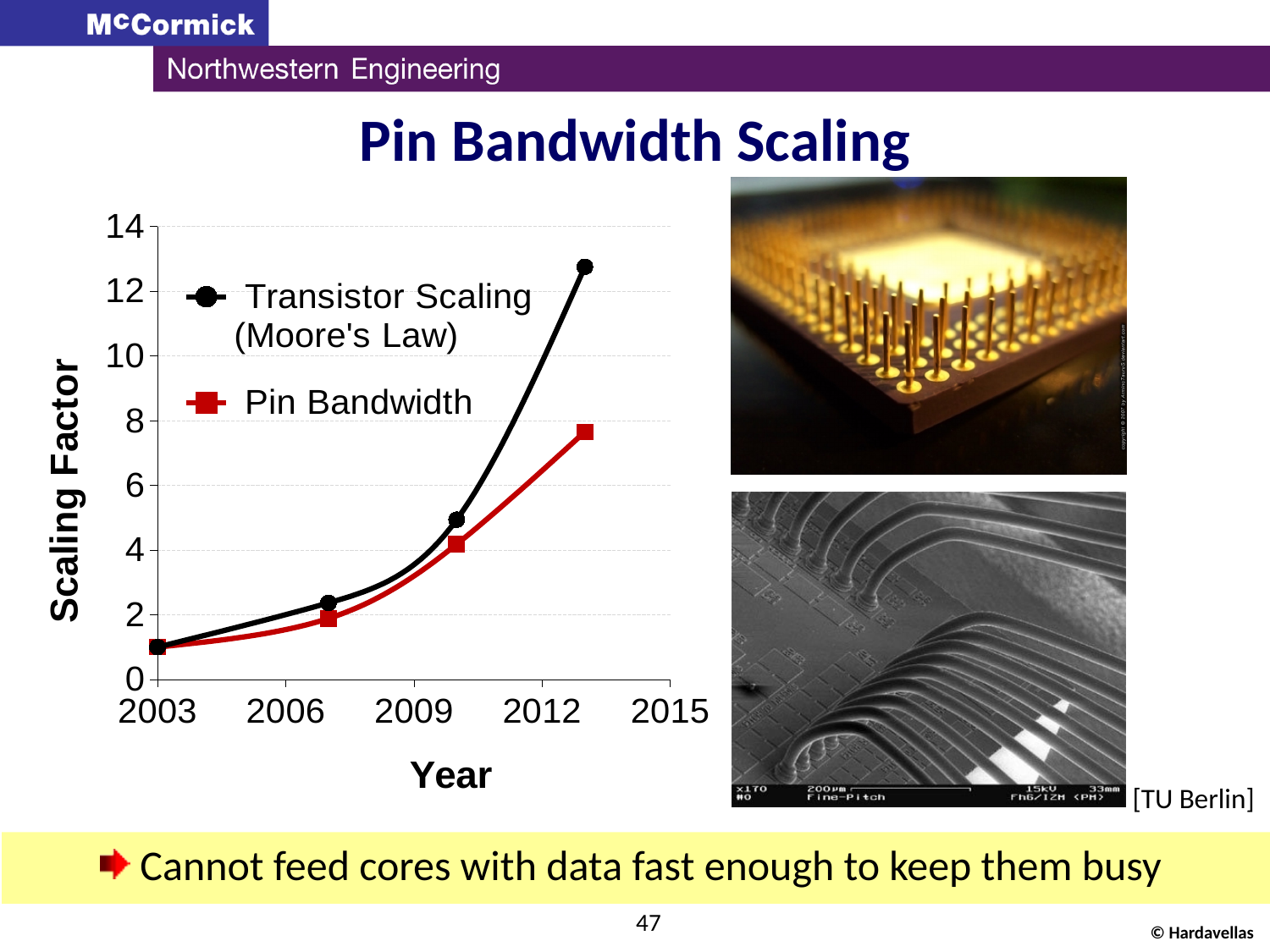
Which series reaches the highest scaling factor on the chart? Transistor Scaling (Moore's Law) Is the final value of the Pin Bandwidth series greater or less than 10? less What is the title of the chart's y axis? Scaling Factor At the last plotted year, which series has the higher scaling factor: Transistor Scaling (Moore's Law) or Pin Bandwidth? Transistor Scaling (Moore's Law) How many data points are plotted for the Pin Bandwidth series? 4 Is the final value of the Transistor Scaling (Moore's Law) series greater or less than 12? greater How many series does the chart legend list? 2 What kind of chart is shown on the slide? line chart Is the final value of the Pin Bandwidth series greater or less than 6? greater Does the Transistor Scaling (Moore's Law) series rise or fall as the year increases? rise What are the two series named in the chart legend? Transistor Scaling (Moore's Law) and Pin Bandwidth Does the Pin Bandwidth series rise or fall along the x axis? rise